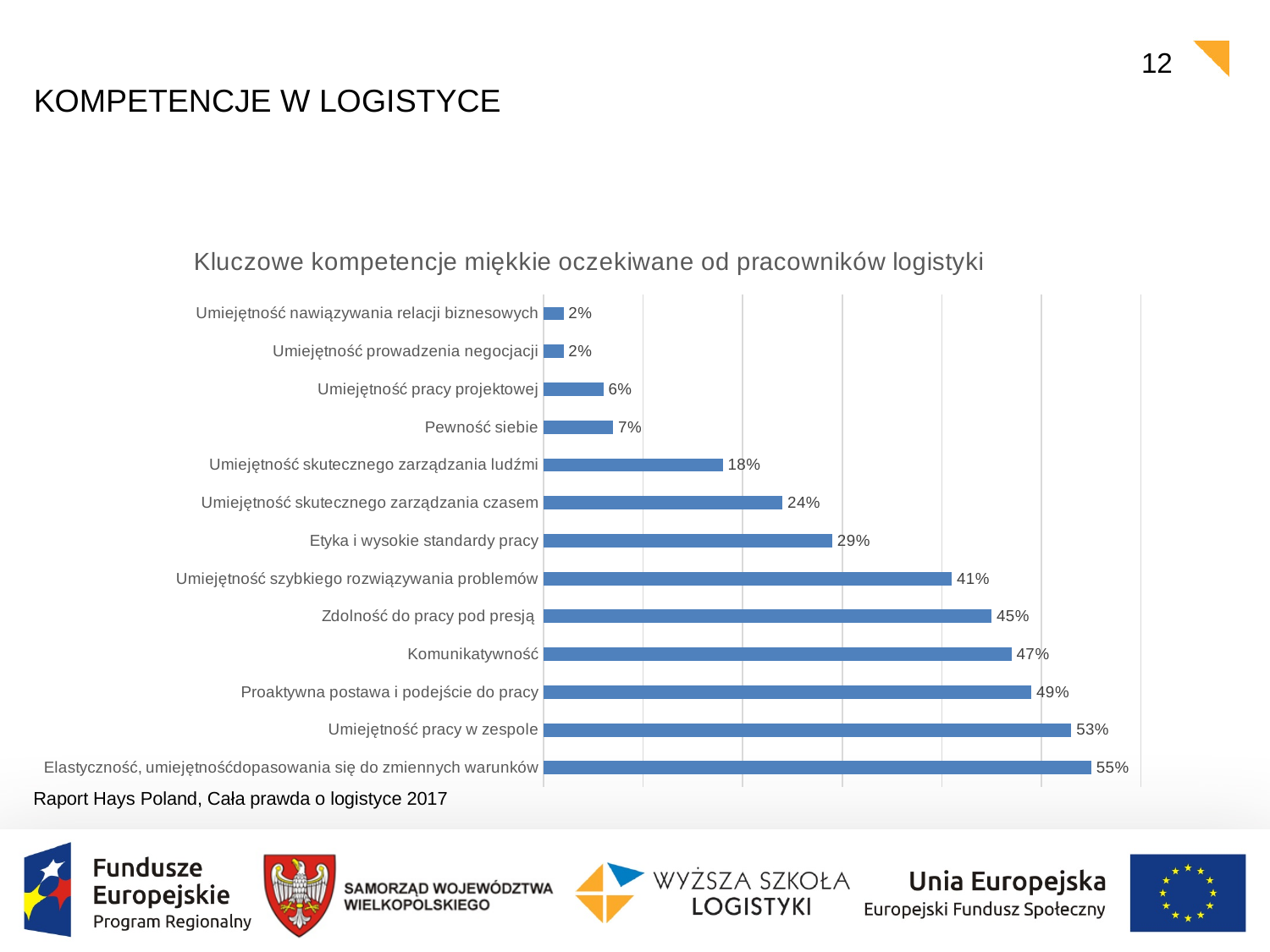
Which category has the lowest value, Umiejętność pracy projektowej or Pewność siebie? Umiejętność pracy projektowej What kind of chart is shown on the slide? Bar chart What is the difference between the values for Proaktywna postawa i podejście do pracy and Umiejętność pracy w zespole? 4% What is the value for Pewność siebie? 7% Which category has the highest value? Elastyczność, umiejętność dopasowania się do zmiennych warunków How many categories are shown in the chart? 13 What is the value for Etyka i wysokie standardy pracy? 29% What is the difference between the values for Komunikatywność and Umiejętność skutecznego zarządzania czasem? 23% What is the title of the chart? Kluczowe kompetencje miękkie oczekiwane od pracowników logistyki What is the value for Umiejętność pracy w zespole? 53% What is the value for Umiejętność skutecznego zarządzania ludźmi? 18% Which is larger, the value for Zdolność do pracy pod presją or the value for Umiejętność szybkiego rozwiązywania problemów? Zdolność do pracy pod presją